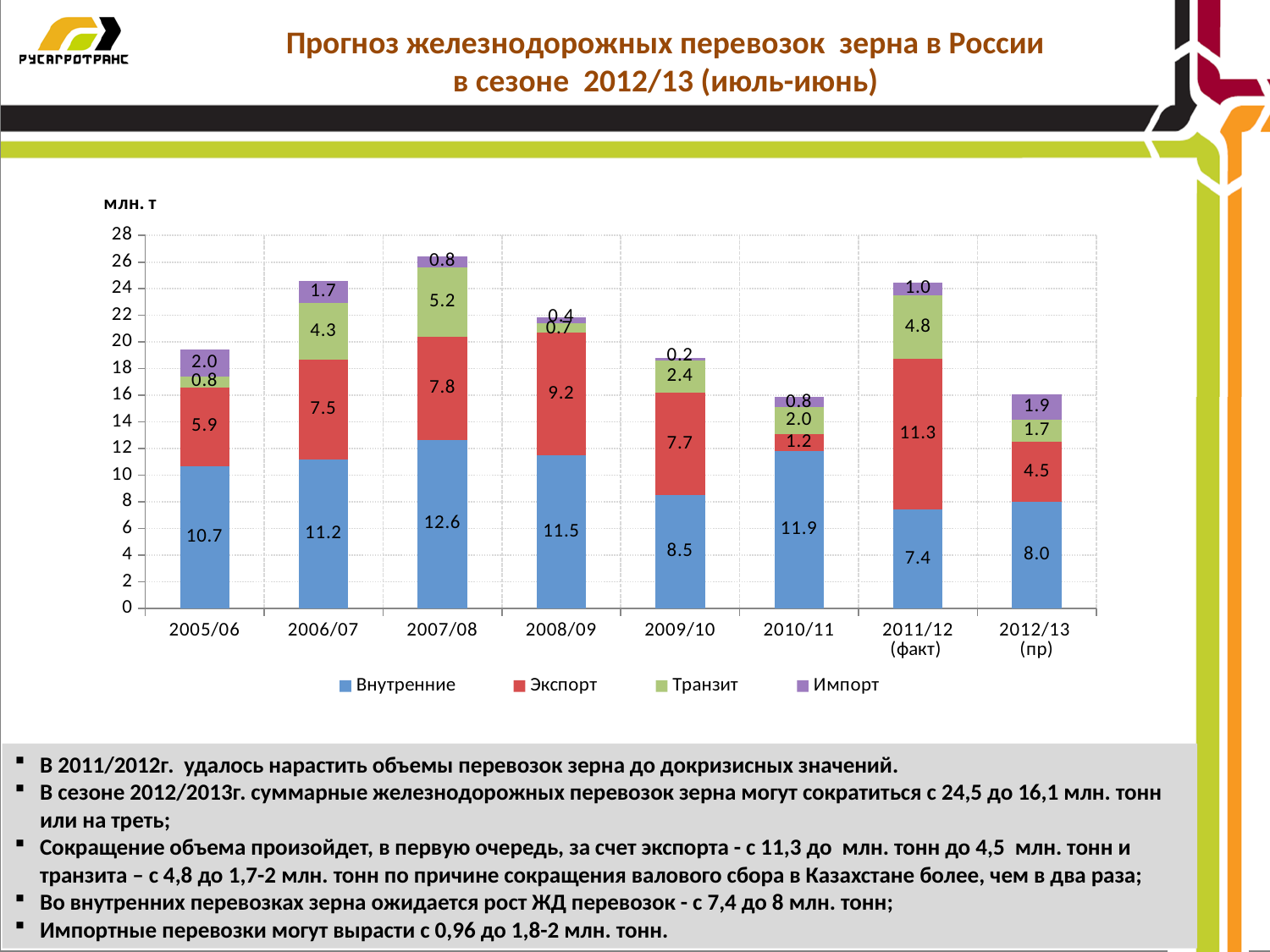
What kind of chart is shown on the slide? Stacked bar chart How many seasons are shown on the x axis? 8 What unit is shown above the y axis of the chart? млн. т How many series does the legend list? 4 What is the value of Транзит for 2012/13 (пр)? 1.7 What is the total of the stacked bar for 2012/13 (пр)? 16.1 Which is larger: the Транзит value for 2007/08 or for 2011/12 (факт)? 2007/08 What is the value of Экспорт for 2011/12 (факт)? 11.3 What is the value of Внутренние for 2007/08? 12.6 Which season has the lowest value for Экспорт? 2010/11 Which season has the highest value for Внутренние? 2007/08 What is the difference between the Экспорт values for 2011/12 (факт) and 2012/13 (пр)? 6.8